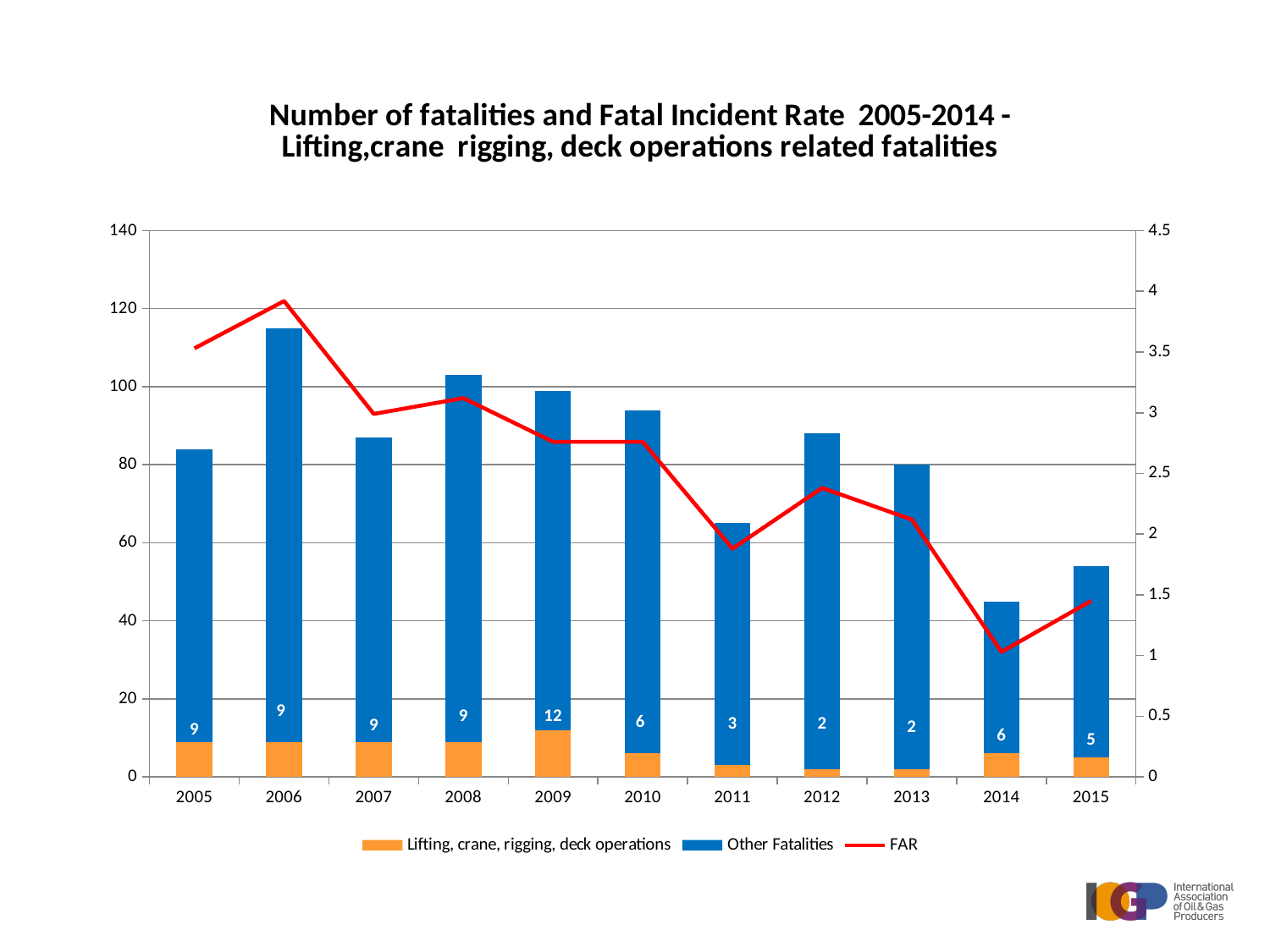
Which year has the highest value for Lifting, crane, rigging, deck operations? 2009 How many series does the legend list? 3 What is the value for Lifting, crane, rigging, deck operations in 2009? 12 What is the difference between the Lifting, crane, rigging, deck operations values for 2009 and 2011? 9 Which series is plotted as a red line? FAR Is the total height of the stacked bar for 2006 greater or less than 100? greater What is the value for Lifting, crane, rigging, deck operations in 2015? 5 Is the total height of the stacked bar for 2014 greater or less than 60? less Which is larger, the Lifting, crane, rigging, deck operations value for 2014 or for 2015? 2014 Does the FAR line generally rise or fall from 2006 to 2014? fall What is the value for Lifting, crane, rigging, deck operations in 2012? 2 How many years are shown on the x axis? 11